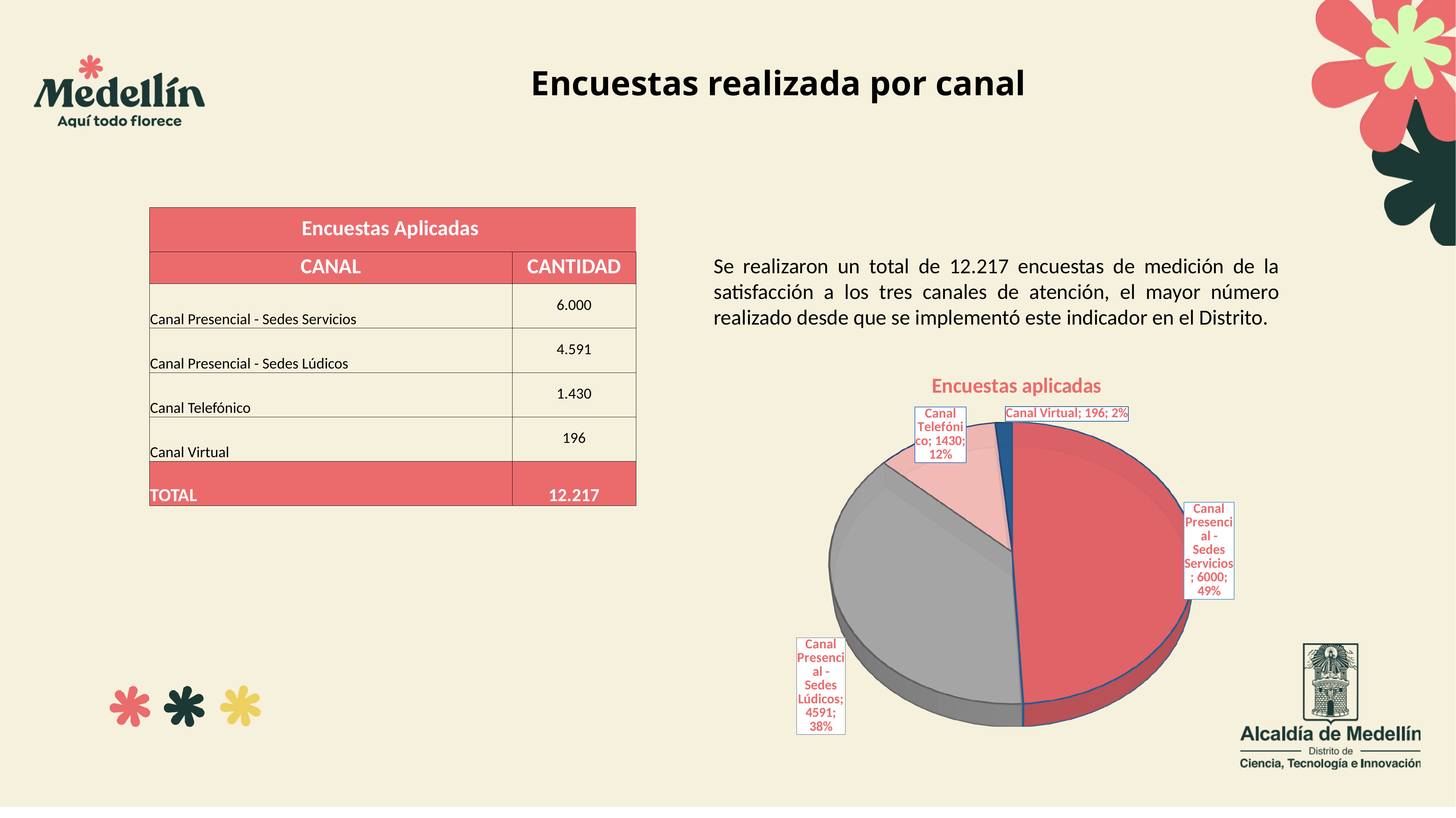
What is the title of the pie chart? Encuestas aplicadas What is the difference between the values for Canal Presencial - Sedes Servicios and Canal Presencial - Sedes Lúdicos in the pie chart? 1409 Which category has the largest slice in the pie chart? Canal Presencial - Sedes Servicios Which category has the smallest slice in the pie chart? Canal Virtual How many slices does the pie chart have? 4 Which is larger in the pie chart, Canal Telefónico or Canal Virtual? Canal Telefónico What kind of chart is shown on the slide? Pie chart What value is shown for Canal Virtual in the pie chart? 196 What value is shown for Canal Presencial - Sedes Servicios in the pie chart? 6000 What value is shown for Canal Telefónico in the pie chart? 1430 What value is shown for Canal Presencial - Sedes Lúdicos in the pie chart? 4591 What share of the pie does Canal Presencial - Sedes Lúdicos represent? 38%